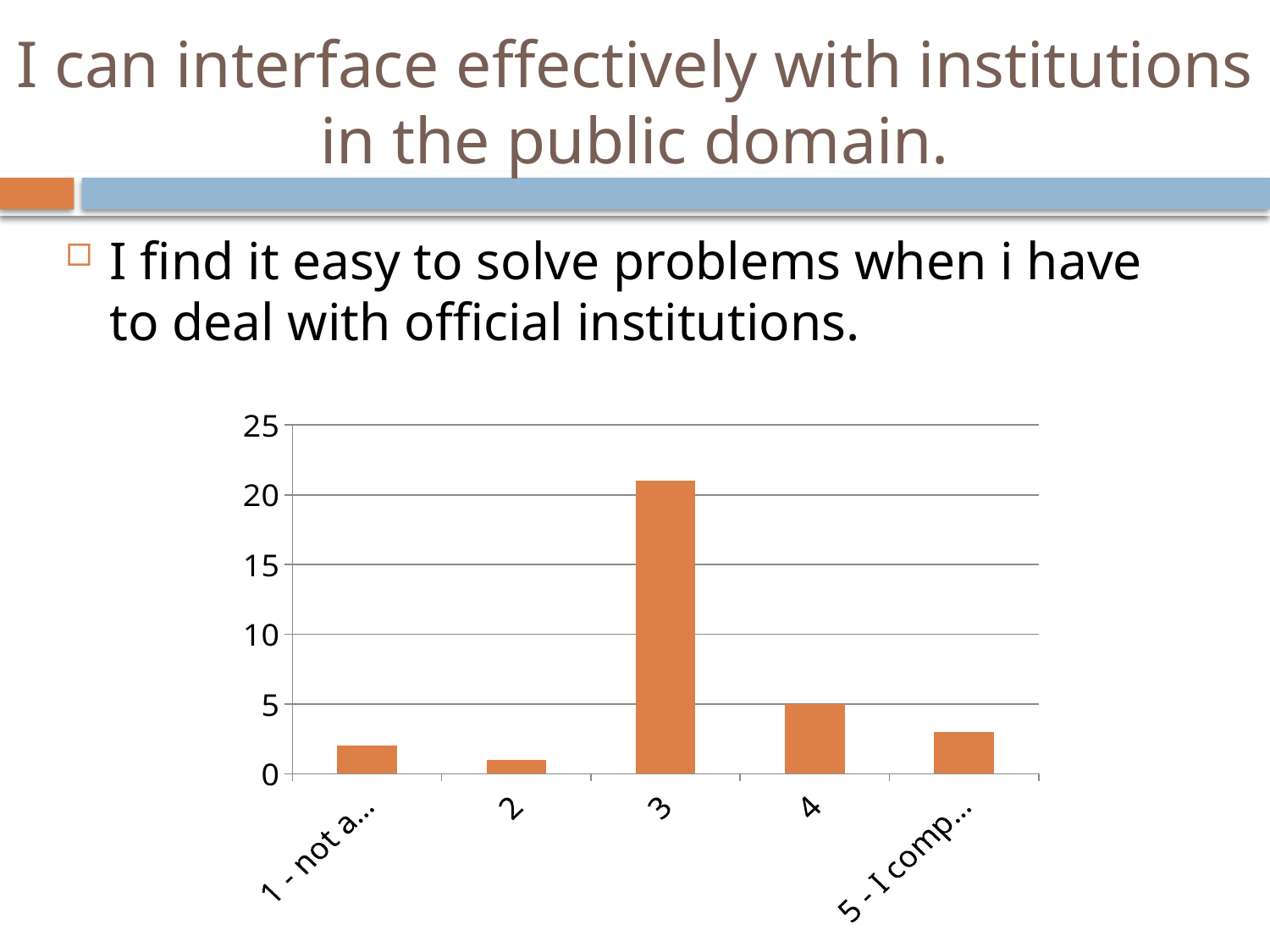
What is the value for category 4? 5 Is the value for category 3 greater or less than 25? less What colour are the bars in the chart? orange Which category has the highest bar in the chart? 3 Which category has the lowest bar in the chart? 2 Is the value for category 2 greater or less than 5? less How many categories are shown on the x axis of the chart? 5 Is the value for category 3 greater or less than 20? greater Which is larger, the value for category 3 or the value for category 4? 3 Which is larger, the value for category 4 or the value for the category labelled '5 - I comp...'? 4 What kind of chart is shown on the slide? bar chart